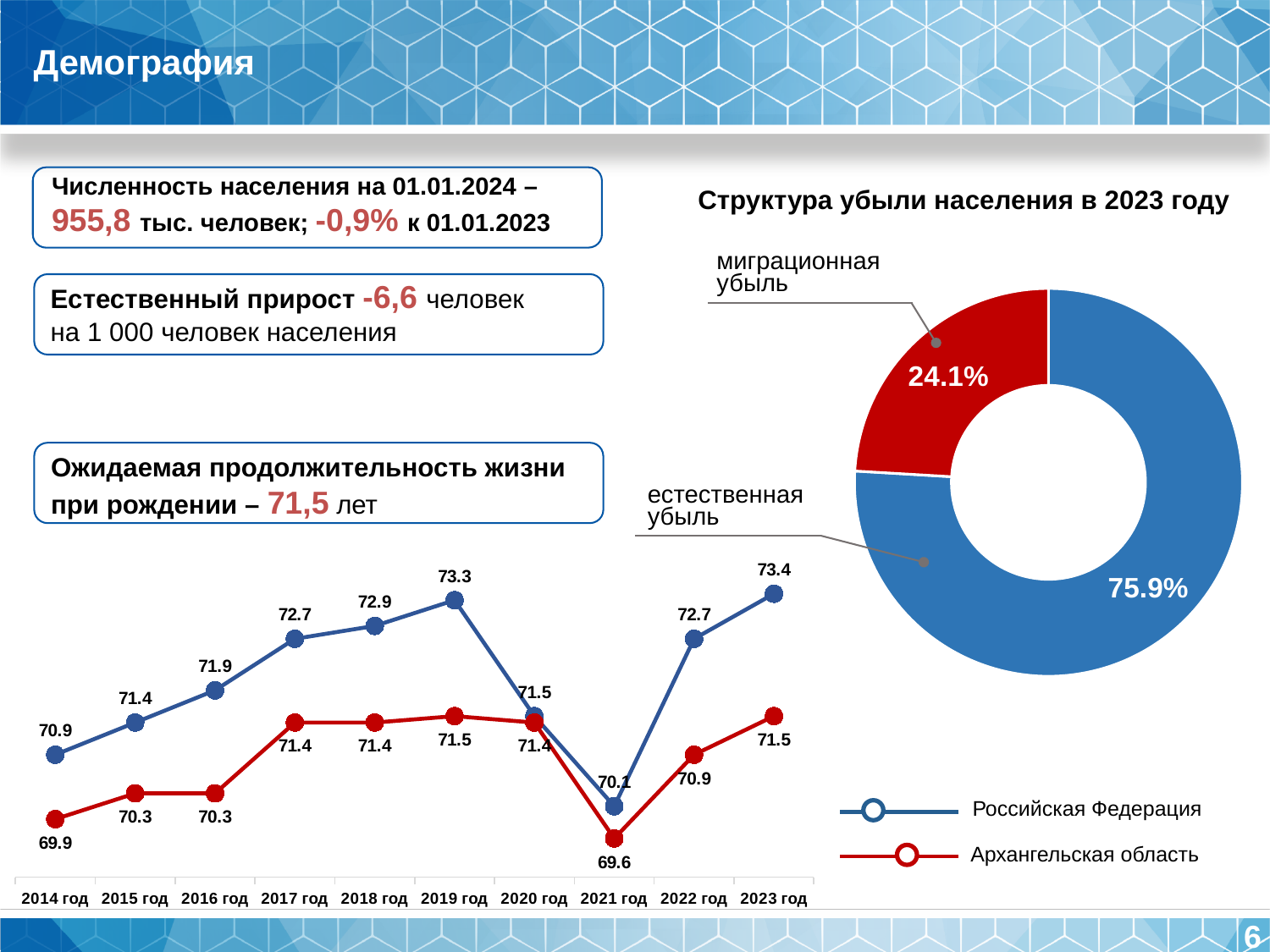
In the pie chart 'Структура убыли населения в 2023 году', what share is labelled for миграционная убыль? 24.1% In the line chart at the bottom left, how many years are shown on the x axis? 10 In the pie chart 'Структура убыли населения в 2023 году', how many slices are there? 2 In the line chart at the bottom left, how many series does the legend list? 2 In the line chart at the bottom left, what is the value for Архангельская область in 2021 год? 69.6 In the pie chart 'Структура убыли населения в 2023 году', what share is labelled for естественная убыль? 75.9% In the line chart at the bottom left, in which year is the value for Архангельская область lowest? 2021 год In the line chart at the bottom left, what is the value for Российская Федерация in 2019 год? 73.3 In the pie chart 'Структура убыли населения в 2023 году', which slice is larger? естественная убыль In the line chart at the bottom left, in which year is the value for Российская Федерация highest? 2023 год In the line chart at the bottom left, what is the difference between Российская Федерация and Архангельская область in 2023 год? 1.9 In the line chart at the bottom left, which series has the higher value in 2014 год? Российская Федерация